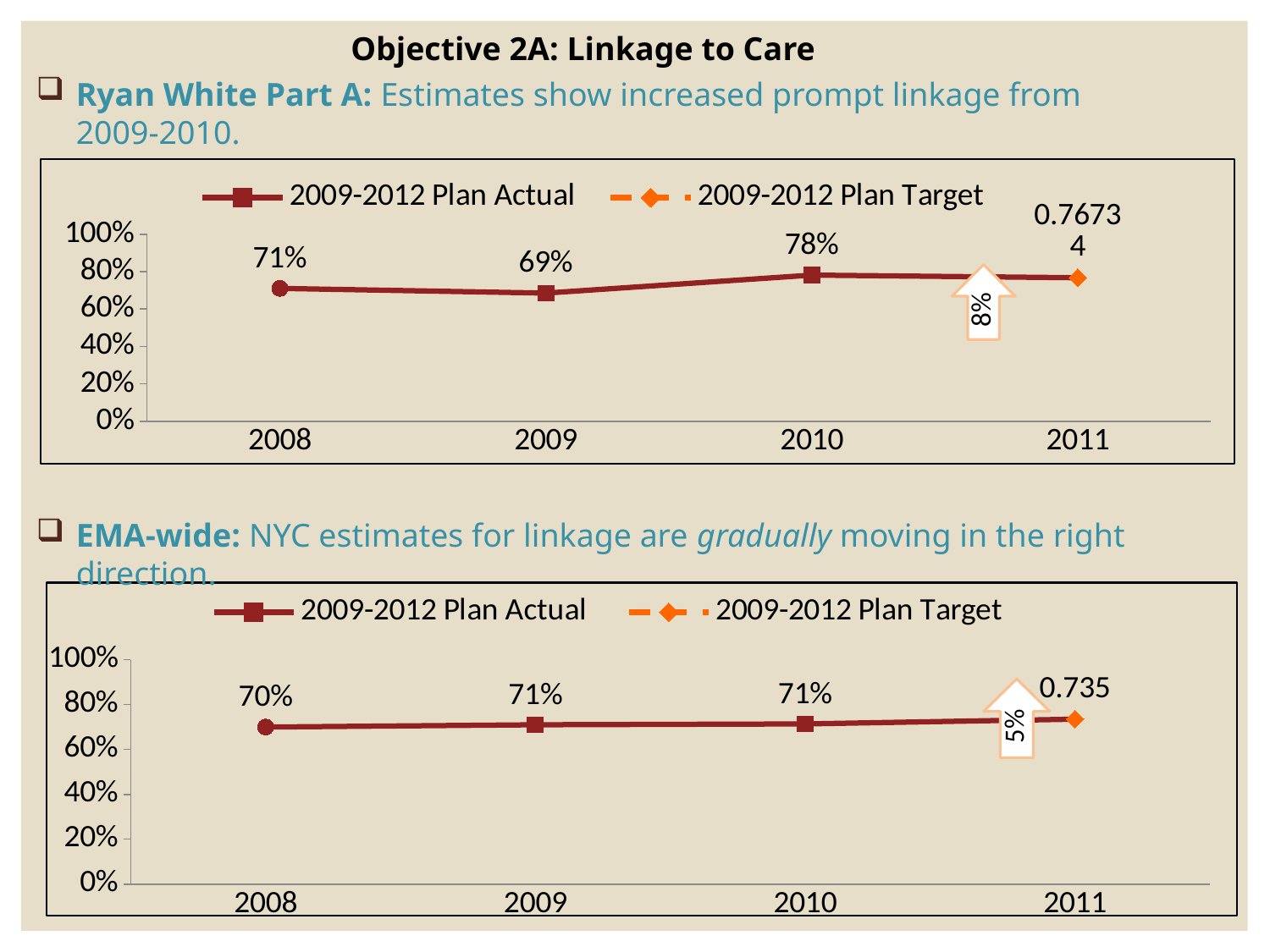
In the top chart (Ryan White Part A), which year has the highest 2009-2012 Plan Actual value? 2010 How many years are shown on the x axis of the top chart (Ryan White Part A)? 4 In the top chart (Ryan White Part A), what is the 2009-2012 Plan Actual value for 2010? 78% In the top chart (Ryan White Part A), what is the difference between the 2010 and 2009 Plan Actual values? 9% What kind of chart is the bottom chart (EMA-wide)? Line chart How many series does the legend of the bottom chart (EMA-wide) list? 2 In the bottom chart (EMA-wide), what is the 2009-2012 Plan Target value shown for 2011? 0.735 In the top chart (Ryan White Part A), is the 2010 Plan Actual value greater or less than the 2008 Plan Actual value? greater In the bottom chart (EMA-wide), what is the 2009-2012 Plan Actual value for 2008? 70% In the bottom chart (EMA-wide), is the 2008 Plan Actual value greater or less than 60%? greater In the top chart (Ryan White Part A), which year has the lowest 2009-2012 Plan Actual value? 2009 In the top chart (Ryan White Part A), what is the 2009-2012 Plan Actual value for 2009? 69%